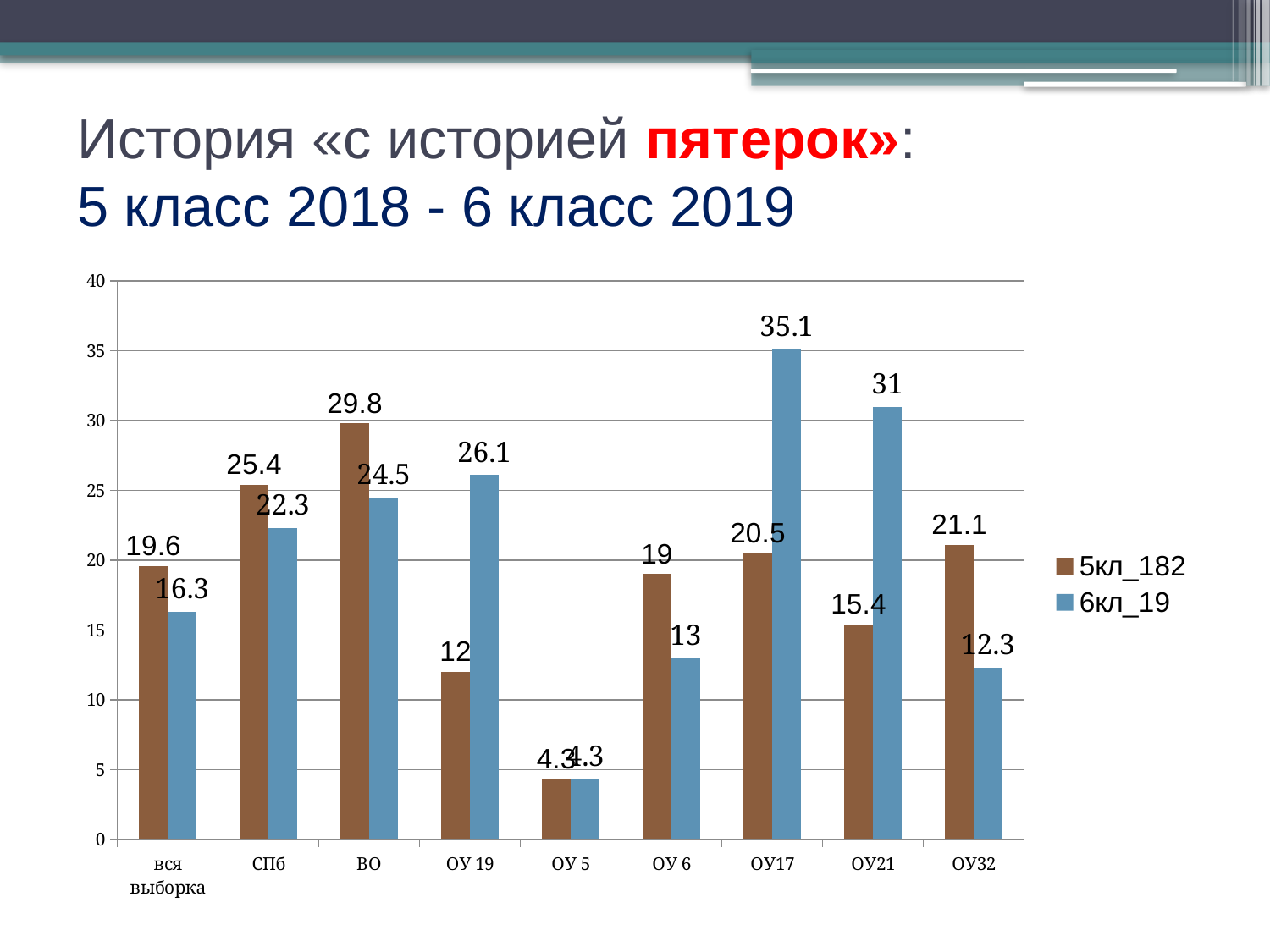
What is the difference between the 6кл_19 and 5кл_182 values for ОУ21? 15.6 Is the 5кл_182 value for СПб greater or less than 25? greater What is the value for ОУ32 in the 6кл_19 series? 12.3 For ОУ 19, which series has the larger value, 5кл_182 or 6кл_19? 6кл_19 What type of chart is shown on the slide? bar chart What is the value for ОУ17 in the 6кл_19 series? 35.1 Which category has the highest value in the 6кл_19 series? ОУ17 How many series does the legend list? 2 Which series is shown in blue in the legend? 6кл_19 How many categories are shown on the x axis? 9 What is the value for ВО in the 5кл_182 series? 29.8 Which category has the lowest value in the 5кл_182 series? ОУ 5